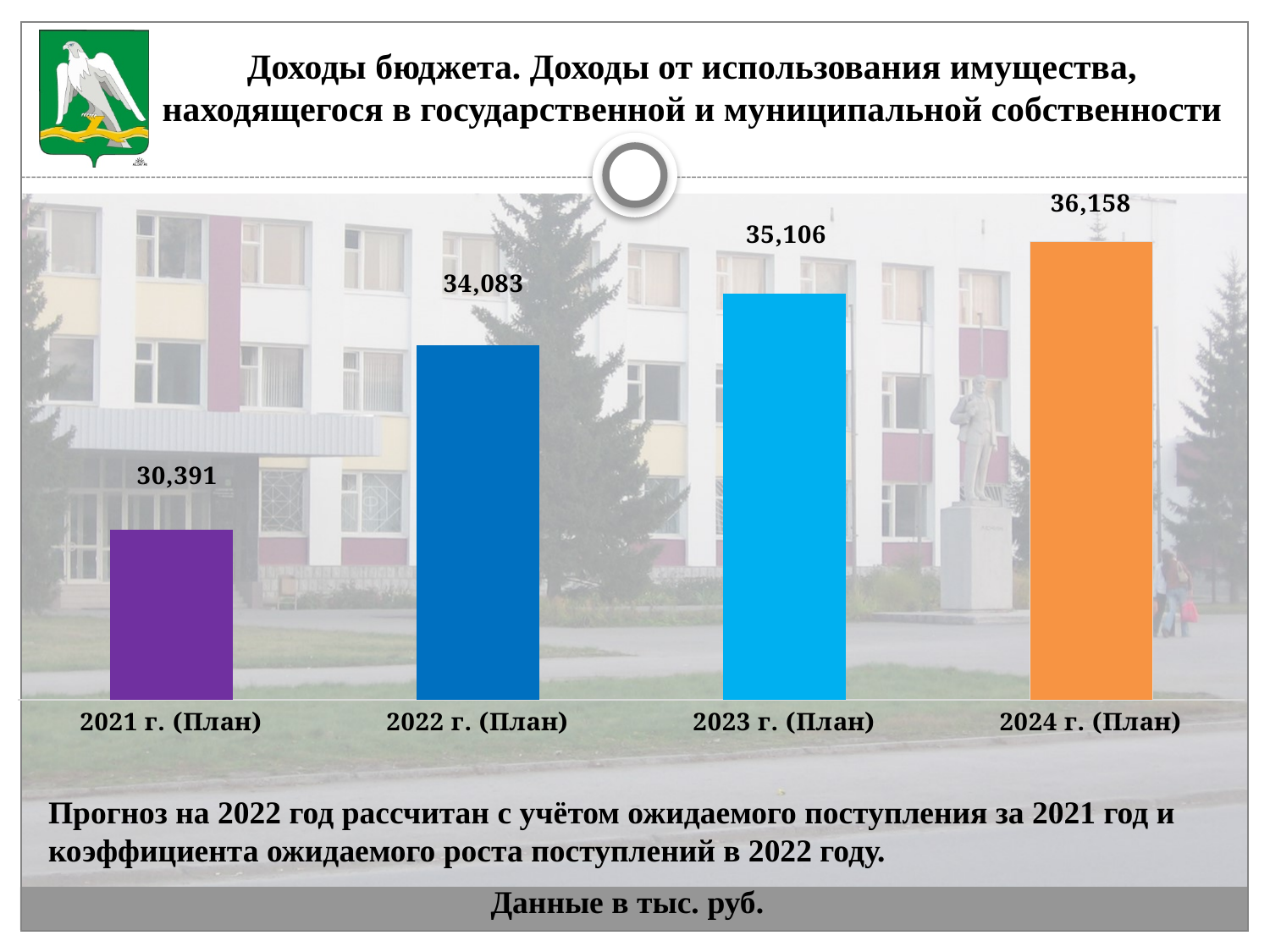
Do the values rise or fall from 2021 to 2024? Rise How many bars are shown in the chart? 4 What is the value for 2021 г. (План)? 30,391 What is the value for 2022 г. (План)? 34,083 Which year has the highest value? 2024 г. (План) What is the value for 2024 г. (План)? 36,158 What is the difference between the values for 2022 г. (План) and 2021 г. (План)? 3,692 What is the value for 2023 г. (План)? 35,106 What is the difference between the values for 2024 г. (План) and 2021 г. (План)? 5,767 Which is larger, the value for 2023 г. (План) or 2022 г. (План)? 2023 г. (План) What kind of chart is shown on the slide? Bar chart Which year has the lowest value? 2021 г. (План)